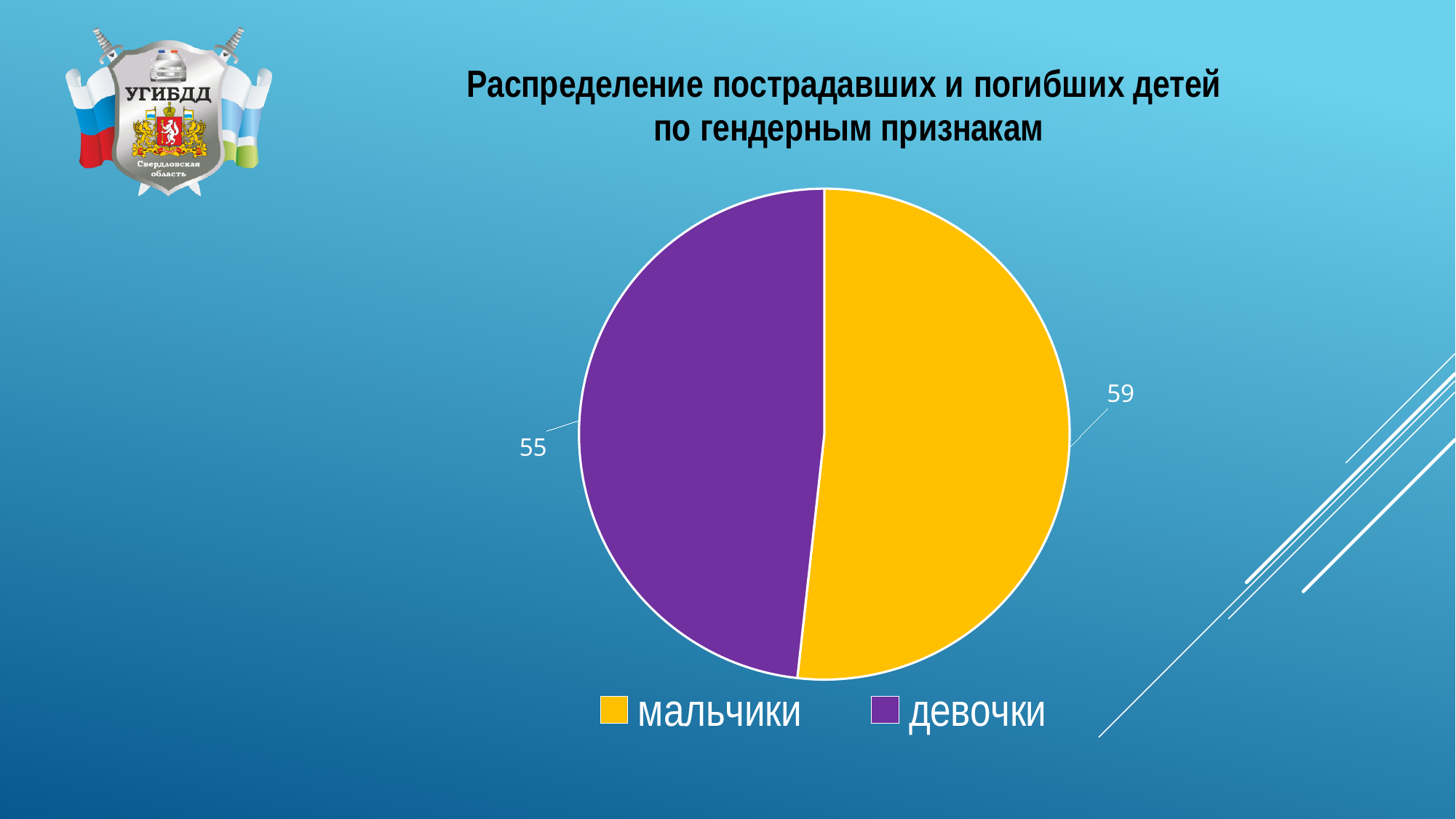
What type of chart is shown on the slide? pie chart What is the difference between the values for мальчики and девочки? 4 Which category has the larger slice in the pie chart? мальчики What is the total of all slices in the pie chart? 114 Which is larger: the value for мальчики or the value for девочки? мальчики How many slices does the pie chart have? 2 What is the title of the chart? Распределение пострадавших и погибших детей по гендерным признакам What is the value for мальчики in the pie chart? 59 What colour is the slice for девочки? purple What is the value for девочки in the pie chart? 55 Which category has the smaller slice in the pie chart? девочки